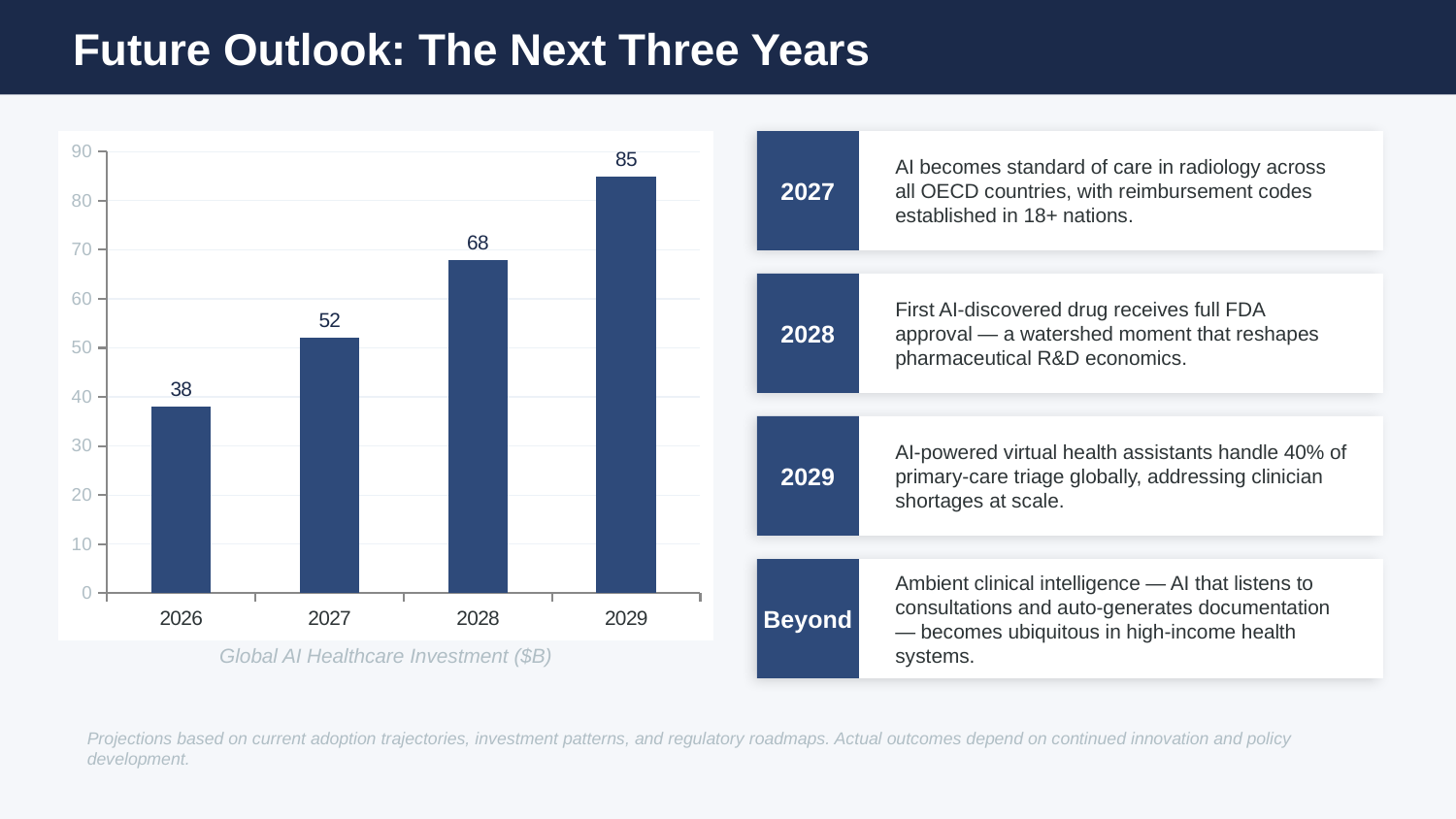
Which is larger in the chart, the value for 2027 or the value for 2028? 2028 What kind of chart is shown on the slide? bar chart What is the Global AI Healthcare Investment value for 2026? 38 Do the values in the chart rise or fall from 2026 to 2029? rise Which year has the lowest Global AI Healthcare Investment? 2026 How many years are shown on the x axis of the chart? 4 What is the difference between the 2029 and 2026 values in the chart? 47 What is the value shown for 2029 in the chart? 85 What is the difference between the 2028 and 2027 values in the chart? 16 Is the value for 2027 greater or less than 60? less Which year has the highest Global AI Healthcare Investment? 2029 What is the Global AI Healthcare Investment value for 2028? 68